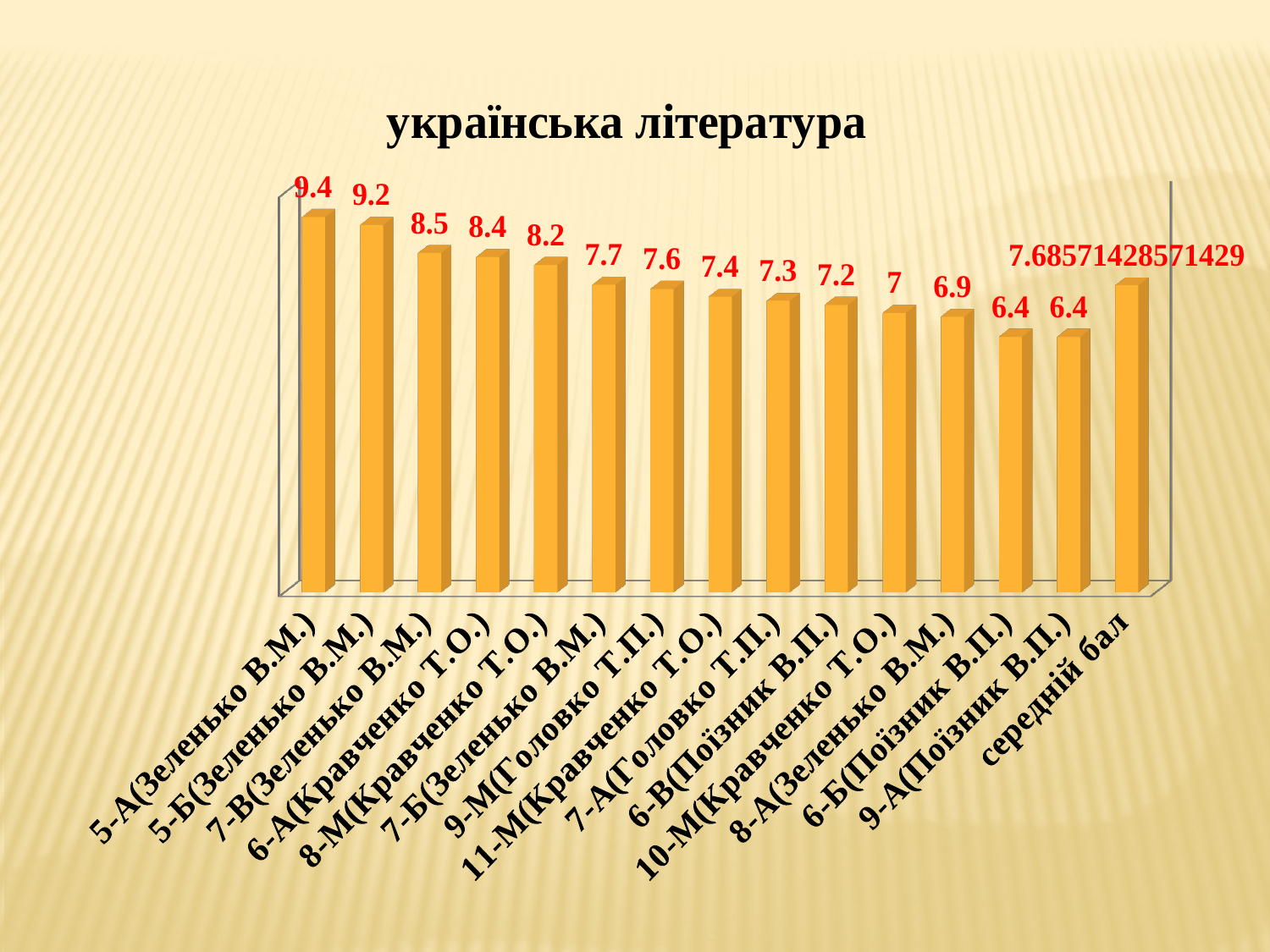
What is the value for 6-А(Кравченко Т.О.)? 8.4 What is the lowest value shown in the chart? 6.4 Which category has the highest value? 5-А(Зеленько В.М.) What is the title of the chart? українська література What is the value for 5-А(Зеленько В.М.)? 9.4 What is the value for 10-М(Кравченко Т.О.)? 7 Which is larger, the value for 7-В(Зеленько В.М.) or the value for 8-М(Кравченко Т.О.)? 7-В(Зеленько В.М.) What is the difference between the values for 5-А(Зеленько В.М.) and 9-А(Поїзник В.П.)? 3 How many bars does the chart have? 15 What is the value shown for середній бал? 7.68571428571429 Do the values rise or fall from 5-А(Зеленько В.М.) to 9-А(Поїзник В.П.) along the x axis? fall What type of chart is shown on the slide? bar chart